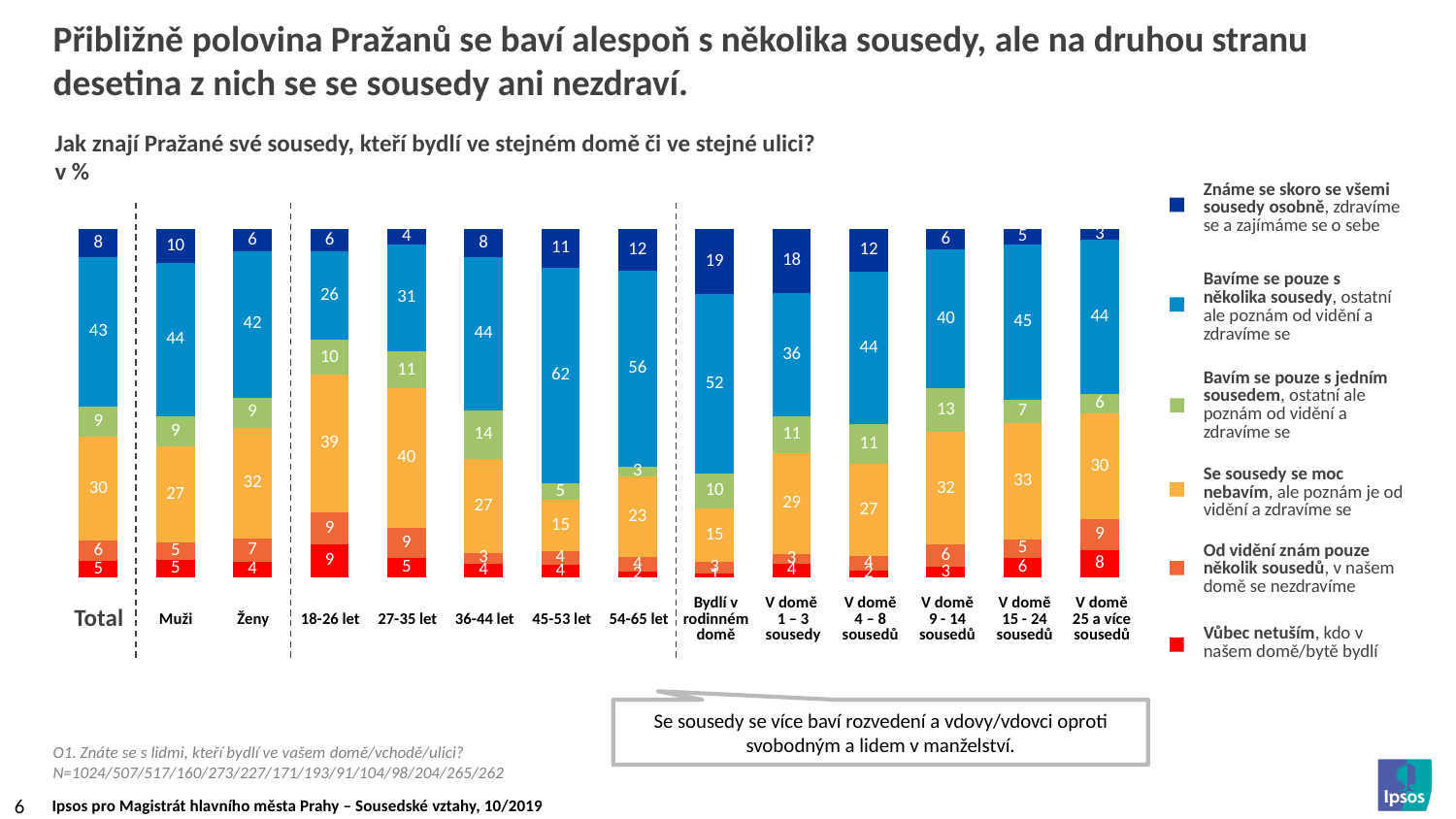
Which category has the highest value for 'Bavíme se pouze s několika sousedy'? 45-53 let What is the value of 'Bavím se pouze s jedním sousedem' for the 36-44 let group? 14 What is the value of 'Známe se skoro se všemi sousedy osobně' for 'Bydlí v rodinném domě'? 19 What is the value of 'Bavíme se pouze s několika sousedy' for the Total bar? 43 How many categories (bars) are plotted on the chart? 14 Which has a larger value for 'Známe se skoro se všemi sousedy osobně': 'V domě 1 – 3 sousedy' or 'V domě 25 a více sousedů'? V domě 1 – 3 sousedy Which category has the lowest value for 'Vůbec netuším, kdo v našem domě/bytě bydlí'? Bydlí v rodinném domě What kind of chart is shown on the slide? stacked bar chart How many series does the legend list? 6 What colour represents 'Vůbec netuším, kdo v našem domě/bytě bydlí' in the chart? red What is the value of 'Se sousedy se moc nebavím' for the 27-35 let group? 40 What is the difference between the 'Se sousedy se moc nebavím' values for Ženy and Muži? 5